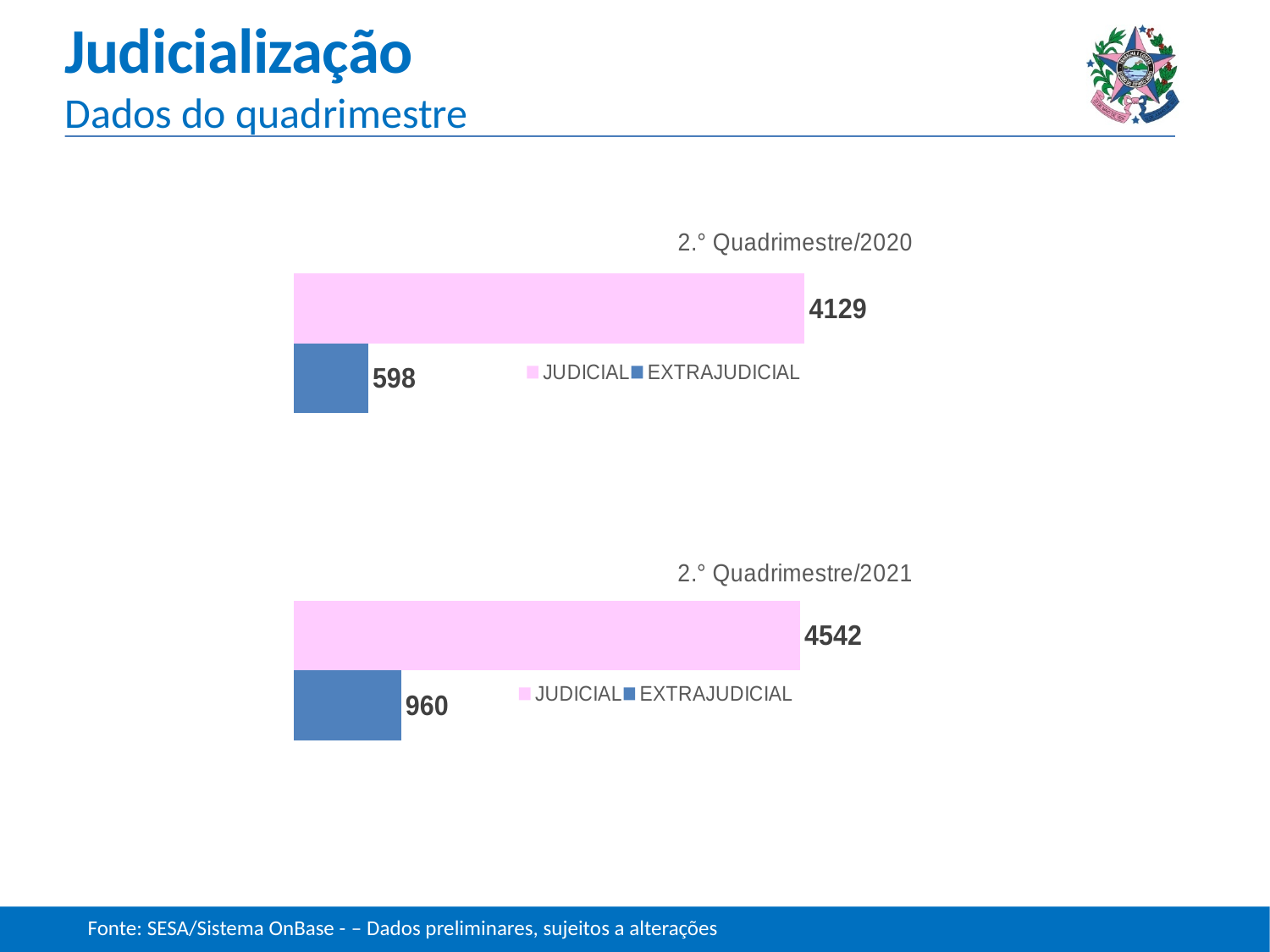
In the chart titled '2.° Quadrimestre/2021', which series has the lowest value? EXTRAJUDICIAL In the chart titled '2.° Quadrimestre/2021', what is the value for JUDICIAL? 4542 In the chart titled '2.° Quadrimestre/2021', what colour is the EXTRAJUDICIAL bar? Blue How many series does the legend of the chart titled '2.° Quadrimestre/2021' list? 2 In the chart titled '2.° Quadrimestre/2020', what is the value for EXTRAJUDICIAL? 598 In the chart titled '2.° Quadrimestre/2020', what is the difference between the JUDICIAL and EXTRAJUDICIAL values? 3531 In the chart titled '2.° Quadrimestre/2020', which series has the highest value? JUDICIAL In the chart titled '2.° Quadrimestre/2021', what is the difference between the JUDICIAL and EXTRAJUDICIAL values? 3582 In the chart titled '2.° Quadrimestre/2021', what is the value for EXTRAJUDICIAL? 960 Is the JUDICIAL value larger in the chart titled '2.° Quadrimestre/2020' or in the chart titled '2.° Quadrimestre/2021'? 2.° Quadrimestre/2021 What kind of chart is the chart titled '2.° Quadrimestre/2020'? Bar chart In the chart titled '2.° Quadrimestre/2020', what is the value for JUDICIAL? 4129